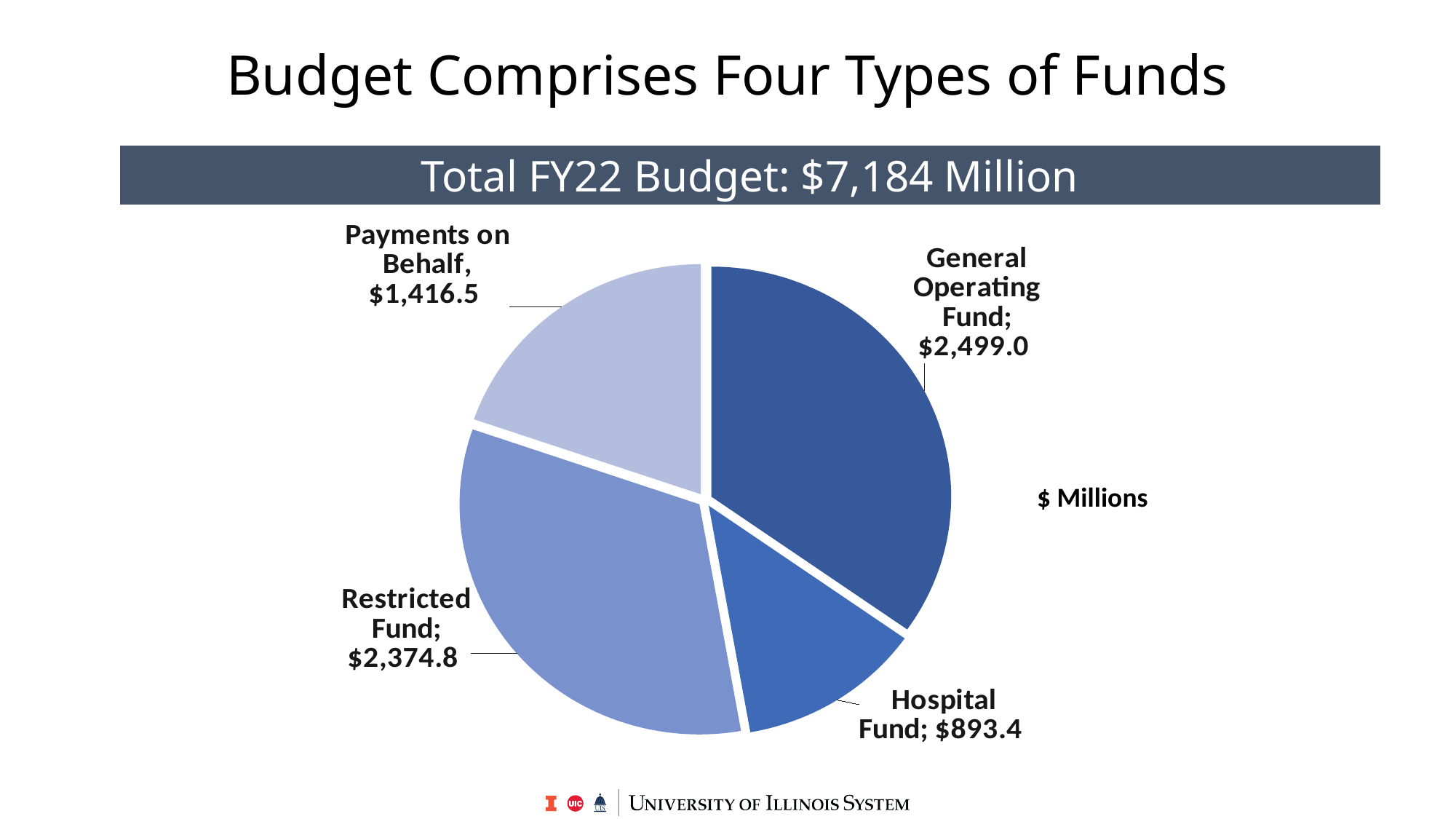
What type of chart is shown on the slide? Pie chart What is the difference between the Payments on Behalf and Hospital Fund values? $523.1 Which fund type has the largest slice of the pie? General Operating Fund What is the value for Payments on Behalf? $1,416.5 What is the value for the Hospital Fund? $893.4 What is the value for the Restricted Fund? $2,374.8 Which is larger, the Restricted Fund or Payments on Behalf? Restricted Fund How many slices does the pie chart have? 4 What is the difference between the General Operating Fund and the Restricted Fund values? $124.2 What total FY22 budget is stated in the banner above the chart? $7,184 Million What is the value for the General Operating Fund? $2,499.0 Which fund type has the smallest slice of the pie? Hospital Fund